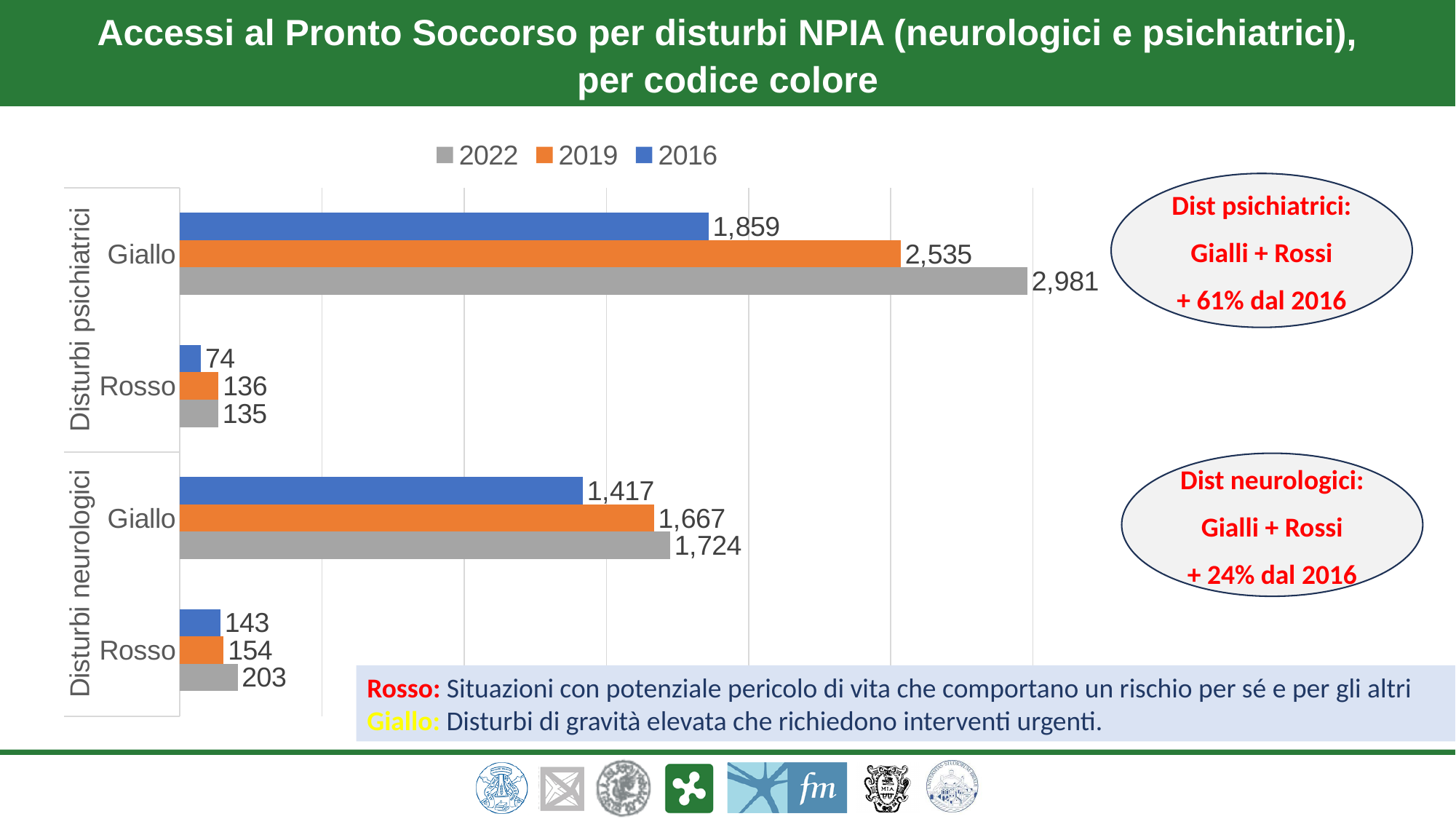
What is the difference between the 2022 and 2016 values for Giallo under Disturbi psichiatrici? 1,122 Which category and year has the lowest value on the chart? Rosso, Disturbi psichiatrici, 2016 Did the Giallo value for Disturbi neurologici rise or fall from 2016 to 2022? Rise Which category and year has the highest value on the chart? Giallo, Disturbi psichiatrici, 2022 What is the 2019 value for Giallo under Disturbi neurologici? 1,667 How many series does the legend list? 3 What is the 2022 value for Giallo under Disturbi psichiatrici? 2,981 What is the 2016 value for Rosso under Disturbi psichiatrici? 74 Which is larger for Rosso under Disturbi psichiatrici: the 2019 value or the 2022 value? 2019 (136) What kind of chart is shown on the slide? Bar chart Which colour represents the 2019 series in the legend? Orange What is the 2022 value for Rosso under Disturbi neurologici? 203